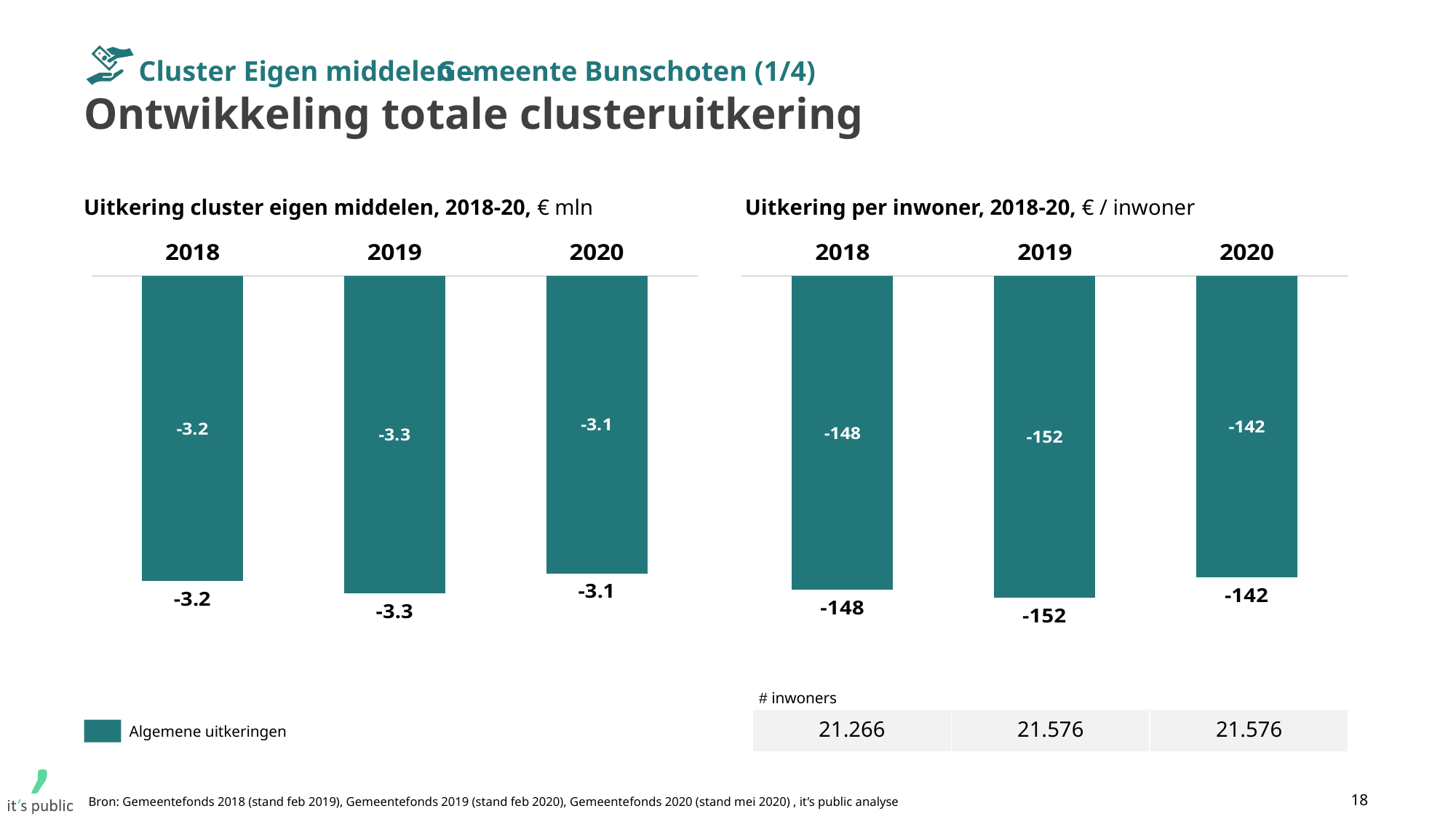
In the chart 'Uitkering per inwoner, 2018-20', what is the difference between the values for 2019 and 2020? 10 In the chart 'Uitkering per inwoner, 2018-20', what is the value for 2020? -142 In the chart 'Uitkering cluster eigen middelen, 2018-20', what is the difference between the values for 2019 and 2020? 0.2 What is the legend entry shown below the left chart? Algemene uitkeringen In the chart 'Uitkering cluster eigen middelen, 2018-20', what is the value for 2020? -3.1 In the chart 'Uitkering per inwoner, 2018-20', which year has the highest (least negative) value? 2020 In the chart 'Uitkering per inwoner, 2018-20', what is the value for 2019? -152 How many years are shown in the chart 'Uitkering cluster eigen middelen, 2018-20'? 3 In the chart 'Uitkering cluster eigen middelen, 2018-20', what is the value for 2018? -3.2 In the chart 'Uitkering cluster eigen middelen, 2018-20', which year has the lowest (most negative) value? 2019 What type of chart is 'Uitkering per inwoner, 2018-20'? Bar chart In the chart 'Uitkering per inwoner, 2018-20', which bar is larger in magnitude, 2018 or 2019? 2019